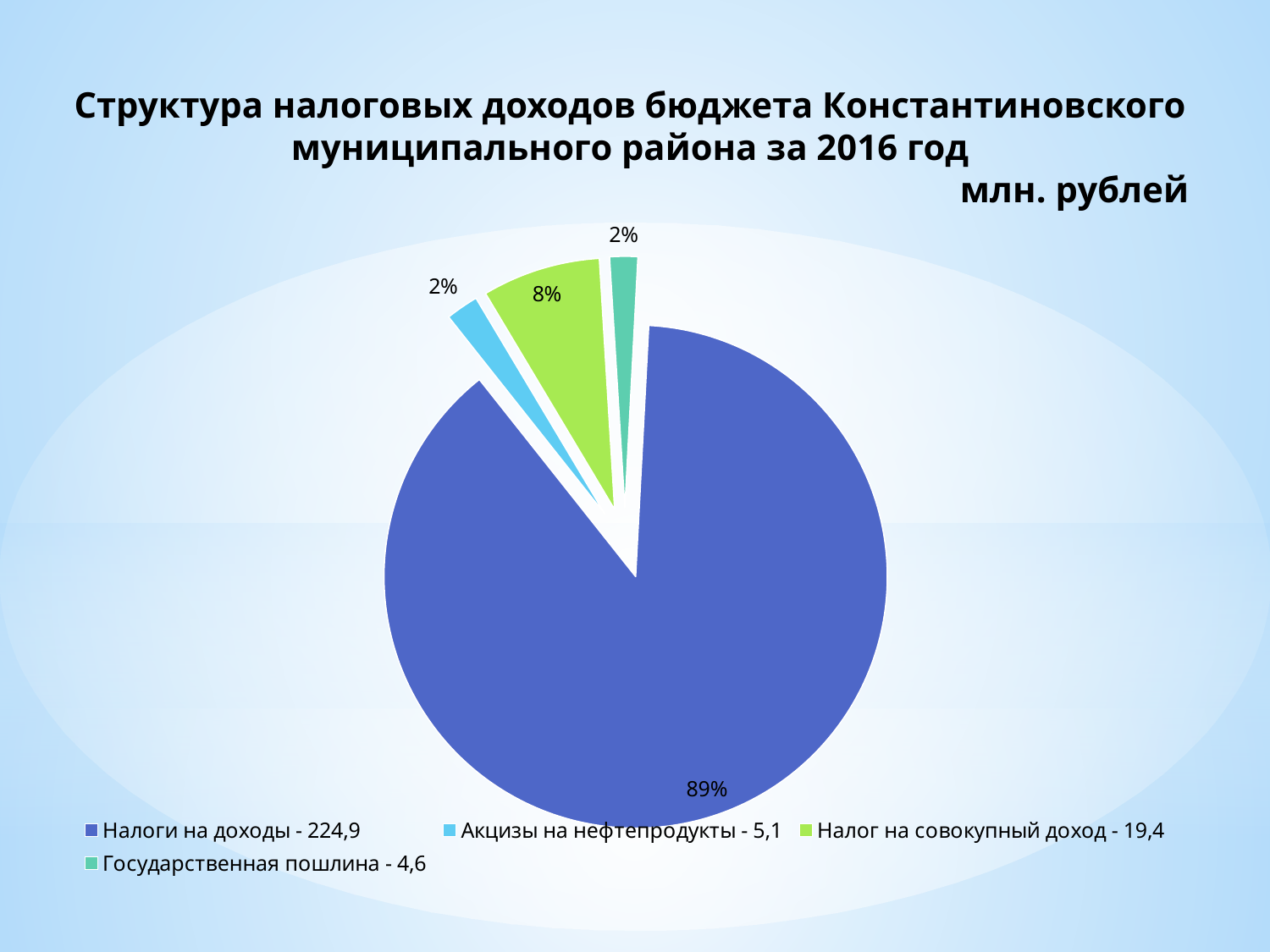
What value is given for Акцизы на нефтепродукты in the legend? 5,1 What kind of chart is shown on the slide? pie chart Which is larger: Налог на совокупный доход or Акцизы на нефтепродукты? Налог на совокупный доход What value is given for Налоги на доходы in the legend? 224,9 How many slices does the pie chart have? 4 What share of the pie does Налог на совокупный доход take? 8% Which category has the smallest value according to the legend? Государственная пошлина What share of the pie does Государственная пошлина take? 2% Which category has the largest value? Налоги на доходы What share of the pie does Налоги на доходы take? 89% How many entries does the legend list? 4 What is the difference between the values for Налоги на доходы and Налог на совокупный доход? 205,5